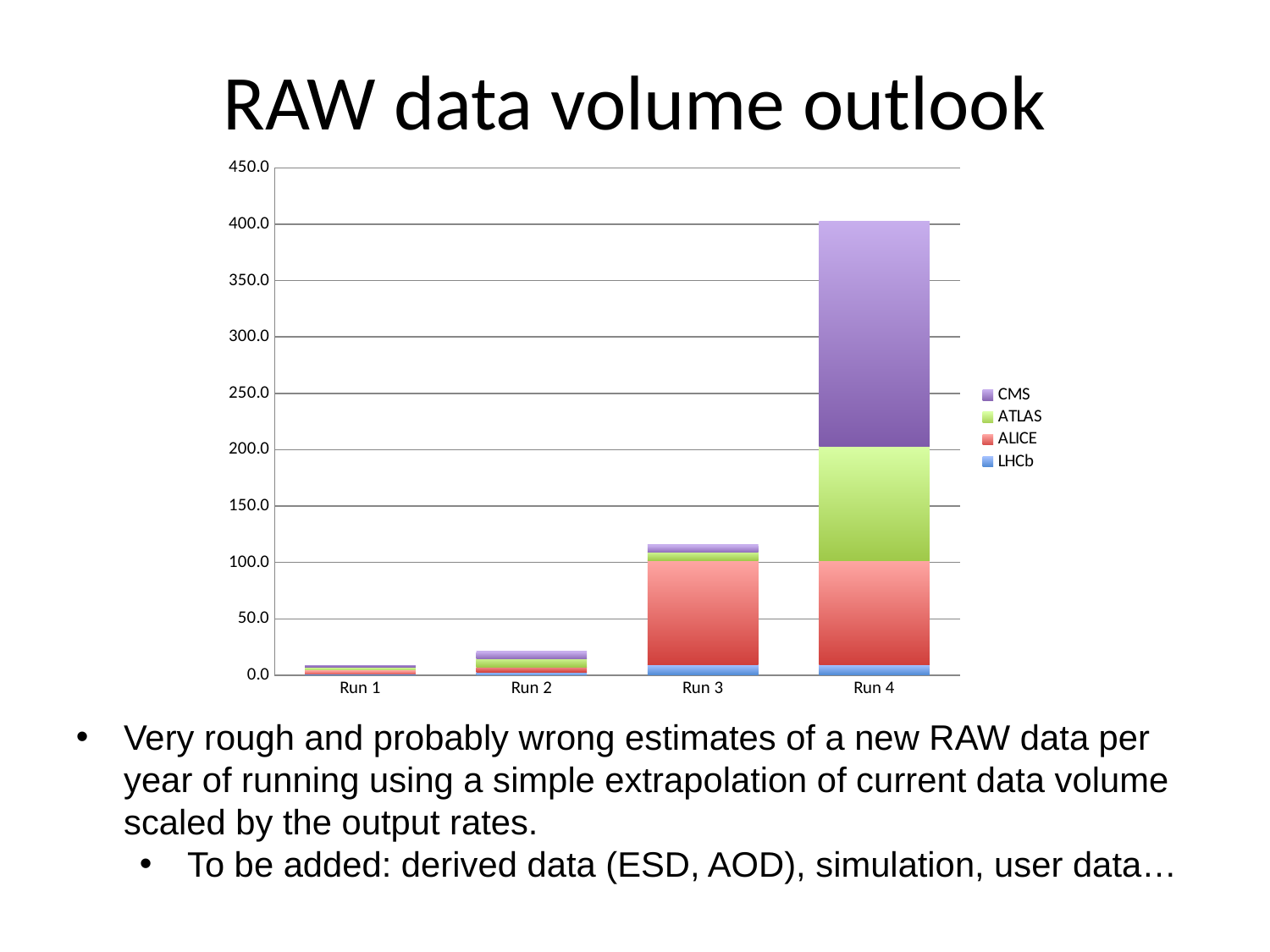
Which run has the highest total RAW data volume? Run 4 How many series does the legend list? 4 What kind of chart is shown on the slide? stacked bar chart Which series is listed first (at the top) in the legend? CMS Which has the larger total bar, Run 2 or Run 3? Run 3 How many categories (runs) are shown on the x axis? 4 Is the total value for Run 3 greater or less than 100? greater What is the title of the slide containing the chart? RAW data volume outlook Which run has the lowest total RAW data volume? Run 1 Do the total bar heights rise or fall from Run 1 to Run 4? rise Is the total value for Run 2 greater or less than 50? less Is the total value for Run 4 greater or less than 350? greater